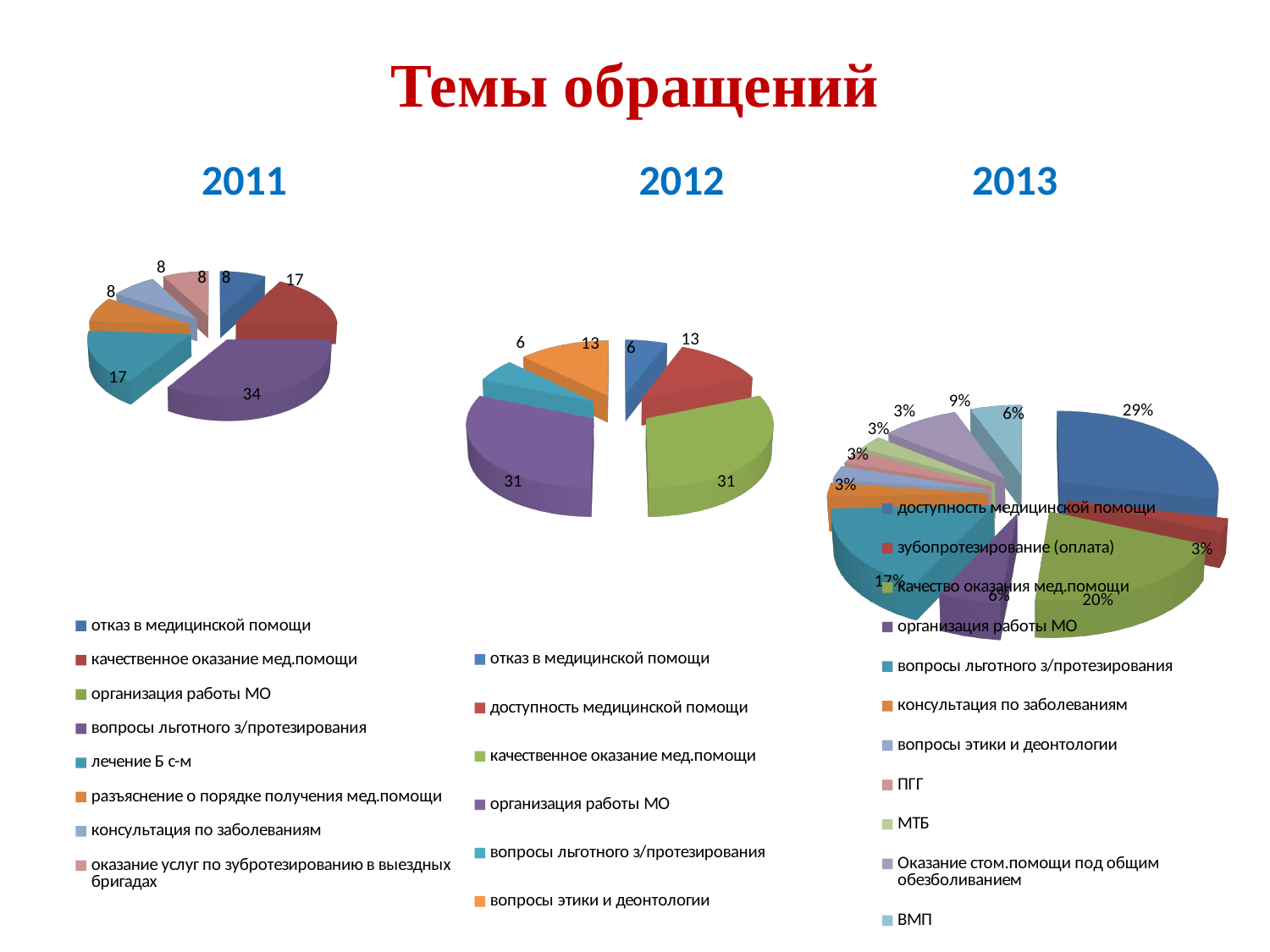
In the 2013 chart, how many categories does the legend list? 11 What kind of charts are shown on the slide? Pie charts In the 2011 chart, what is the value for лечение Б с-м? 17 In the 2012 chart, which is larger: организация работы МО or вопросы этики и деонтологии? организация работы МО In the 2013 chart, what is the share for вопросы льготного з/протезирования? 17% In the 2012 chart, what is the value for отказ в медицинской помощи? 6 In the 2011 chart, what is the difference between вопросы льготного з/протезирования and качественное оказание мед.помощи? 17 In the 2013 chart, which category has the largest share? доступность медицинской помощи In the 2012 chart, how many categories does the legend list? 6 In the 2011 chart, what is the value for вопросы льготного з/протезирования? 34 In the 2011 chart, which category has the largest slice? вопросы льготного з/протезирования In the 2013 chart, what is the share for доступность медицинской помощи? 29%